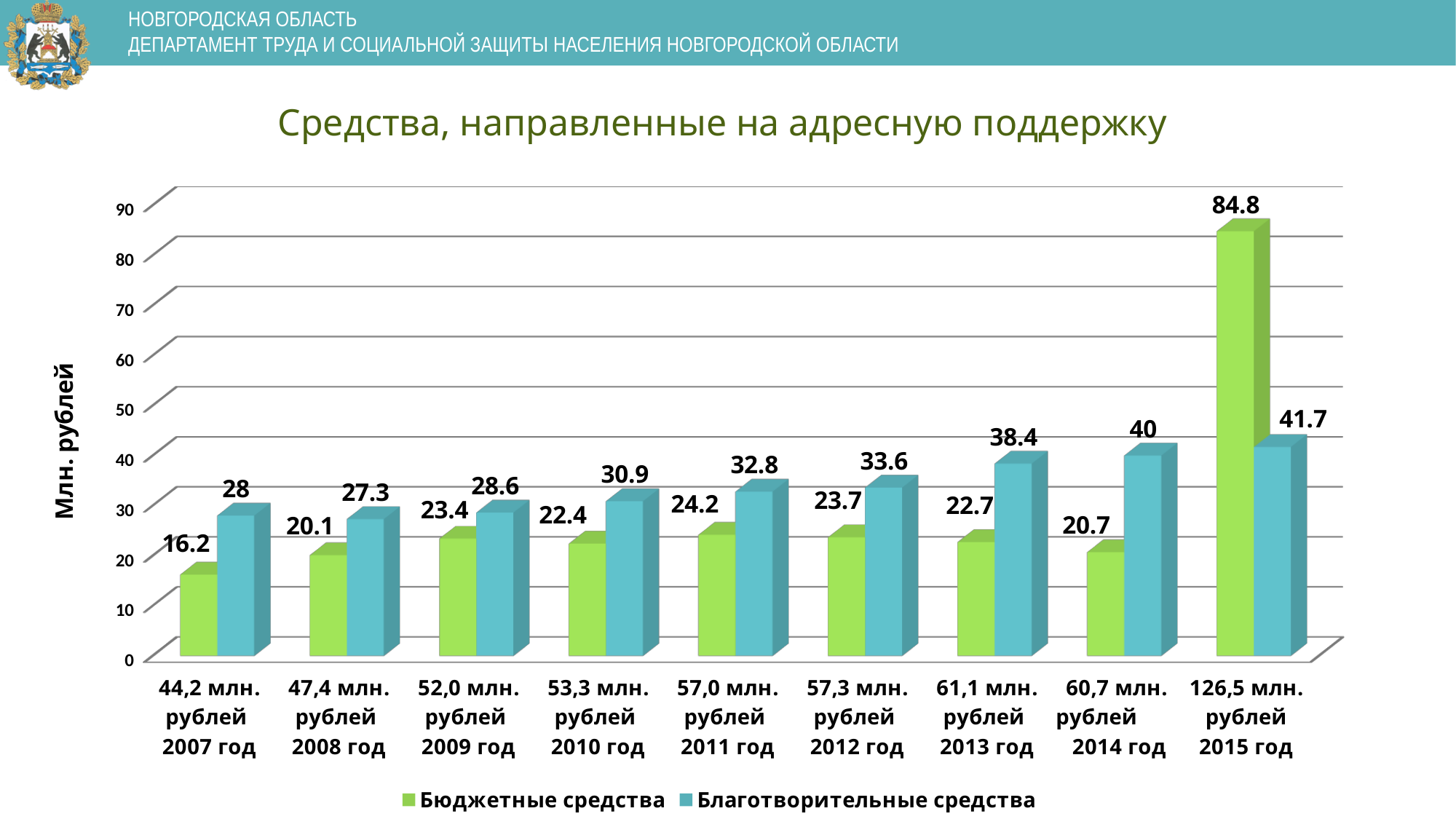
Which year has the highest value for Благотворительные средства? 2015 год What is the value of Бюджетные средства for 2015 год? 84.8 Which year has the lowest value for Бюджетные средства? 2007 год What is the value of Благотворительные средства for 2013 год? 38.4 What is the difference between Благотворительные средства and Бюджетные средства in 2014 год? 19.3 Is the value of Бюджетные средства for 2015 год greater or less than 80? greater How many years are shown on the x axis? 9 How many series does the legend list? 2 Do the values for Благотворительные средства rise or fall from 2007 год to 2015 год? Rise What kind of chart is shown on the slide? Bar chart What is the value of Бюджетные средства for 2007 год? 16.2 Which is larger in 2015 год: Бюджетные средства or Благотворительные средства? Бюджетные средства